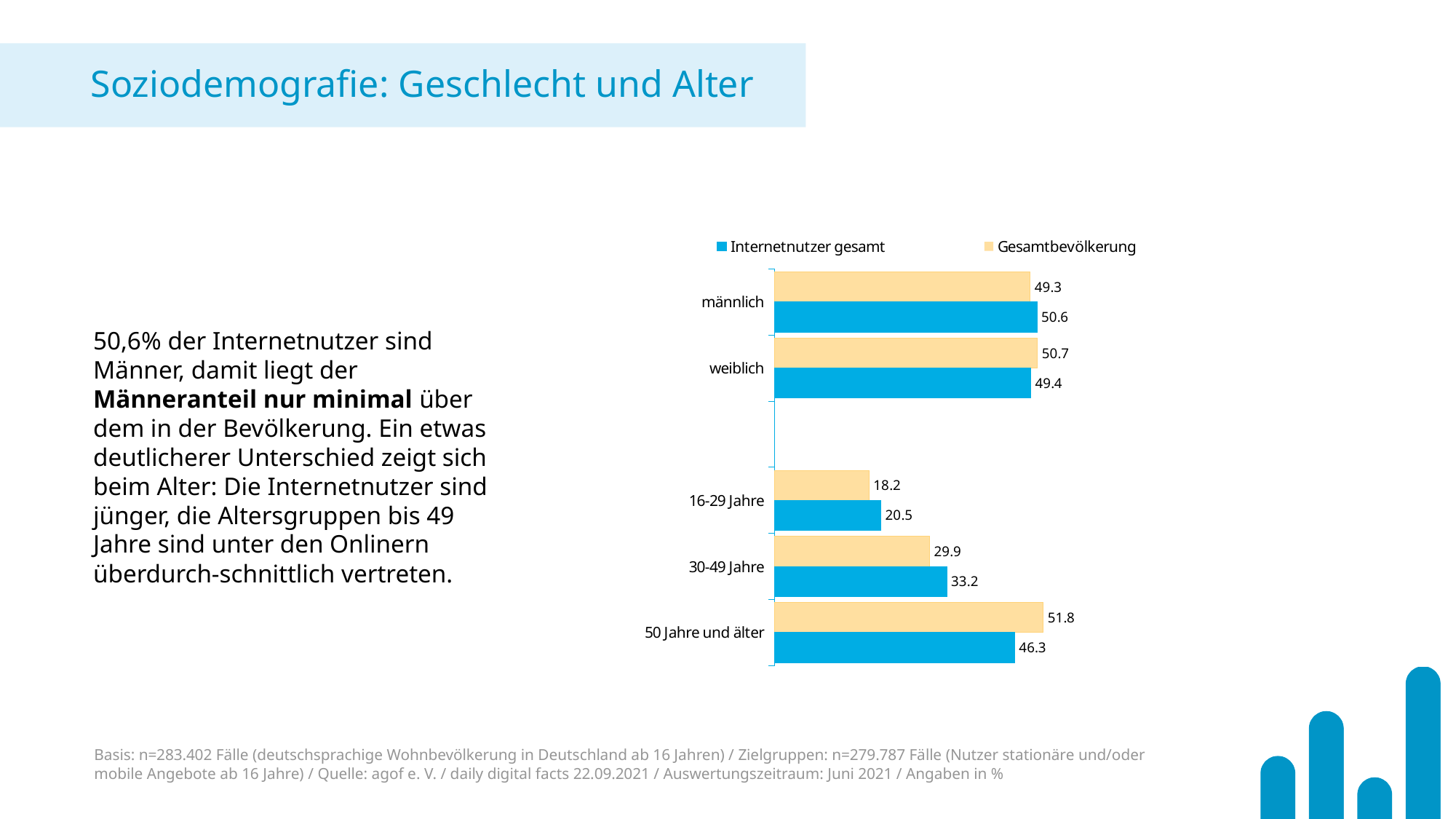
How many categories are shown on the chart? 5 What is the difference between the Internetnutzer gesamt and Gesamtbevölkerung values for 30-49 Jahre? 3.3 For the 16-29 Jahre category, which series has the larger value, Internetnutzer gesamt or Gesamtbevölkerung? Internetnutzer gesamt What kind of chart is shown on the slide? Bar chart For the weiblich category, which series has the larger value, Internetnutzer gesamt or Gesamtbevölkerung? Gesamtbevölkerung What is the value for Internetnutzer gesamt in the männlich category? 50.6 What is the value for Gesamtbevölkerung in the 16-29 Jahre category? 18.2 What is the difference between the Gesamtbevölkerung and Internetnutzer gesamt values for 50 Jahre und älter? 5.5 How many series does the legend list? 2 Which category has the highest Gesamtbevölkerung value? 50 Jahre und älter What is the value for Internetnutzer gesamt in the 50 Jahre und älter category? 46.3 Which category has the lowest Internetnutzer gesamt value? 16-29 Jahre